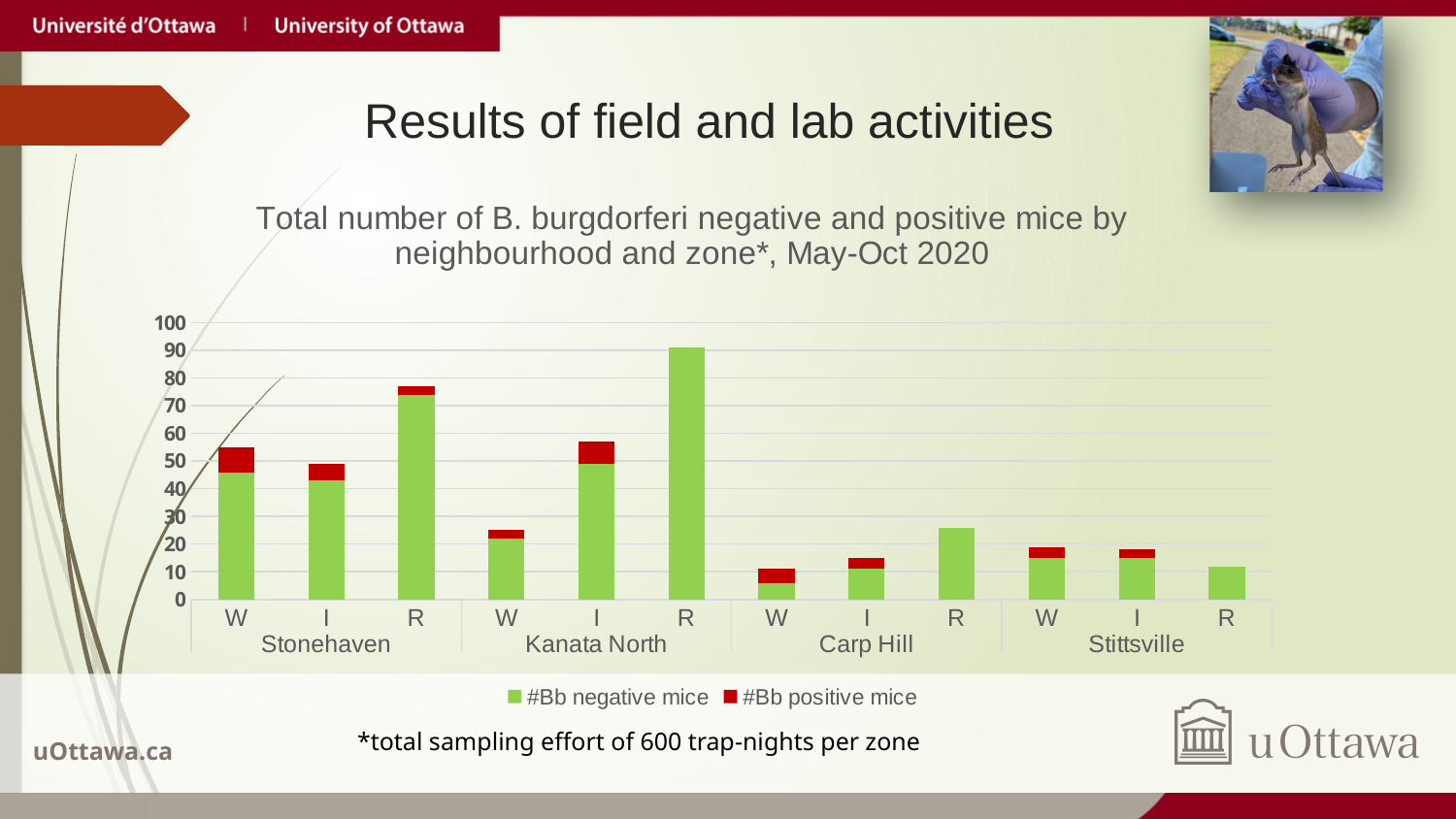
Is the total number of mice for Carp Hill R greater or less than 30? less What colour represents the #Bb positive mice series in the chart? Red Which neighbourhood and zone has the lowest number of Bb negative mice? Carp Hill W Is the total number of mice for Stonehaven R greater or less than 70? greater Which neighbourhood and zone has the highest total number of mice? Kanata North R Is the total number of mice for Stonehaven W greater or less than 50? greater Which has a larger total number of mice, Carp Hill R or Stittsville R? Carp Hill R How many bars (neighbourhood-zone combinations) are plotted in the chart? 12 What kind of chart is shown on the slide? Stacked bar chart How many series does the legend list? 2 Which has a larger total number of mice, Stonehaven R or Kanata North R? Kanata North R